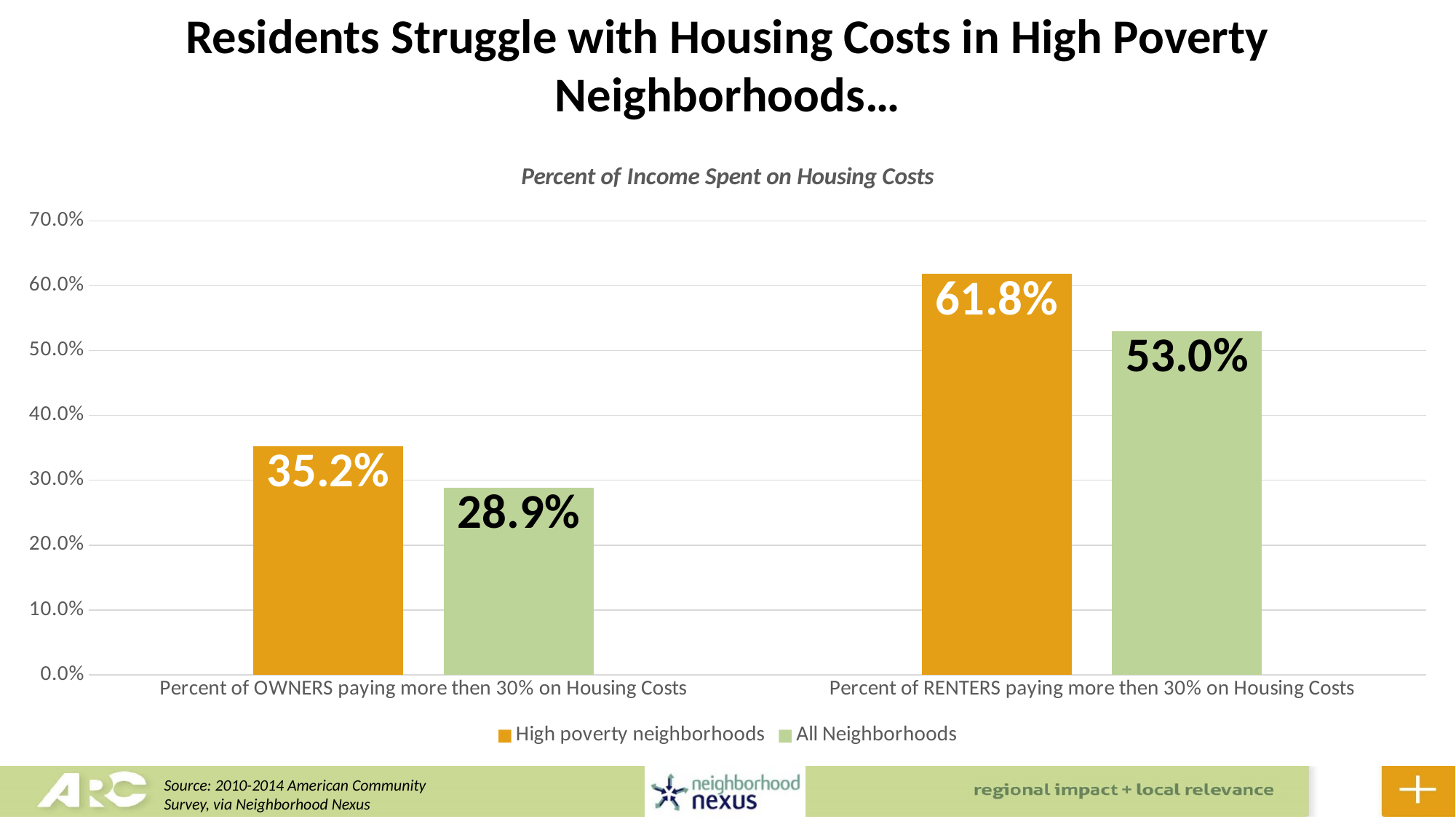
What is the difference between high poverty neighborhoods and all neighborhoods for owners paying more than 30% on housing costs? 6.3 percentage points What percent of renters in high poverty neighborhoods pay more than 30% on housing costs? 61.8% What kind of chart is shown on the slide? Bar chart How many series does the legend list? 2 Which bar shows the highest value on the chart? High poverty neighborhoods, renters (61.8%) What percent of owners in high poverty neighborhoods pay more than 30% on housing costs? 35.2% Which bar shows the lowest value on the chart? All Neighborhoods, owners (28.9%) What is the difference between high poverty neighborhoods and all neighborhoods for renters paying more than 30% on housing costs? 8.8 percentage points What percent of renters in all neighborhoods pay more than 30% on housing costs? 53.0% What is the chart's subtitle above the plot area? Percent of Income Spent on Housing Costs What percent of owners in all neighborhoods pay more than 30% on housing costs? 28.9% For owners, which is larger: high poverty neighborhoods or all neighborhoods? High poverty neighborhoods